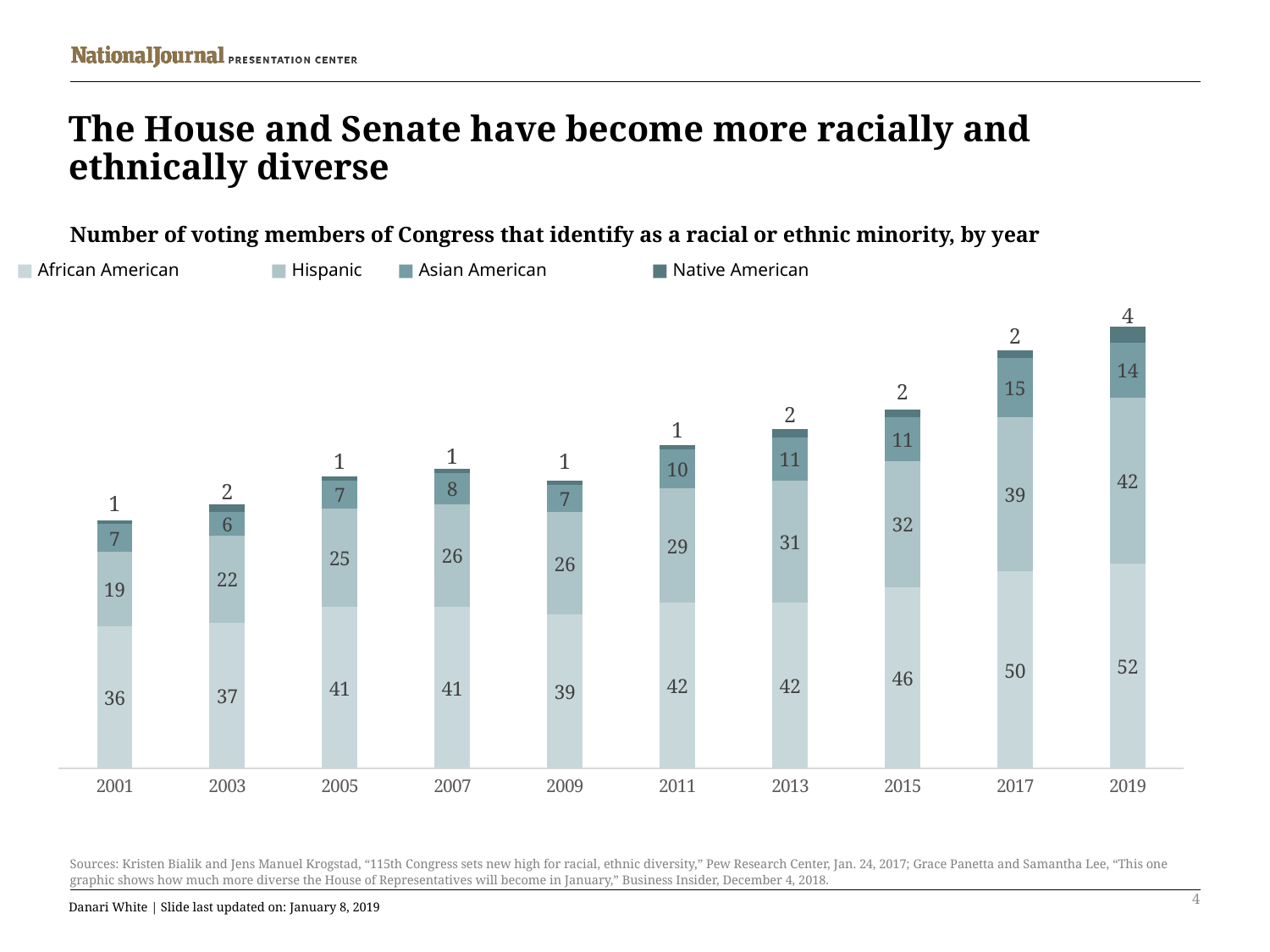
How many series does the legend list? 4 What is the number of Asian American voting members of Congress in 2017? 15 Does the number of African American voting members generally rise or fall from 2001 to 2019? Rise What is the number of Hispanic voting members of Congress in 2013? 31 What is the difference between the number of Hispanic voting members in 2019 and in 2001? 23 In which year is the number of Native American voting members highest? 2019 What is the total number of minority voting members of Congress in 2019? 112 In which year is the number of African American voting members lowest? 2001 What is the number of African American voting members of Congress in 2019? 52 Which is larger: the number of Asian American voting members in 2011 or in 2009? 2011 What type of chart is shown on the slide? Stacked bar chart How many years are shown on the x axis? 10